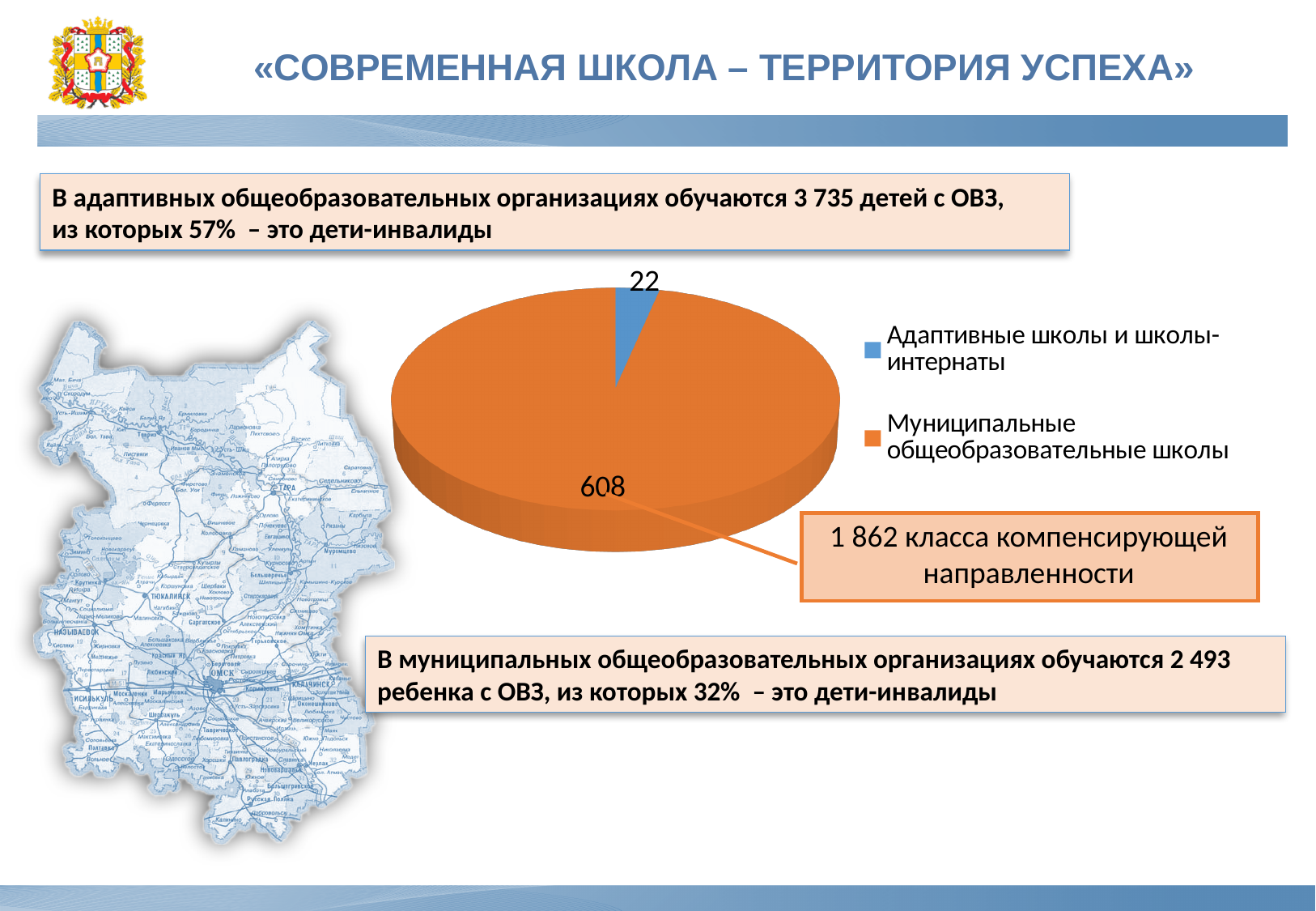
How many slices does the pie chart have? 2 Which category has the largest slice in the pie chart? Муниципальные общеобразовательные школы Which category has the smallest slice in the pie chart? Адаптивные школы и школы-интернаты Which is larger: the value for Адаптивные школы и школы-интернаты or the value for Муниципальные общеобразовательные школы? Муниципальные общеобразовательные школы What is the difference between the values for Муниципальные общеобразовательные школы and Адаптивные школы и школы-интернаты? 586 How many entries does the legend of the pie chart list? 2 What is the value for Муниципальные общеобразовательные школы in the pie chart? 608 What is the value for Адаптивные школы и школы-интернаты in the pie chart? 22 What colour is the slice for Адаптивные школы и школы-интернаты? blue What does the callout box connected to the orange slice say? 1 862 класса компенсирующей направленности What kind of chart is shown on the slide? pie chart What is the total of the two values shown in the pie chart? 630